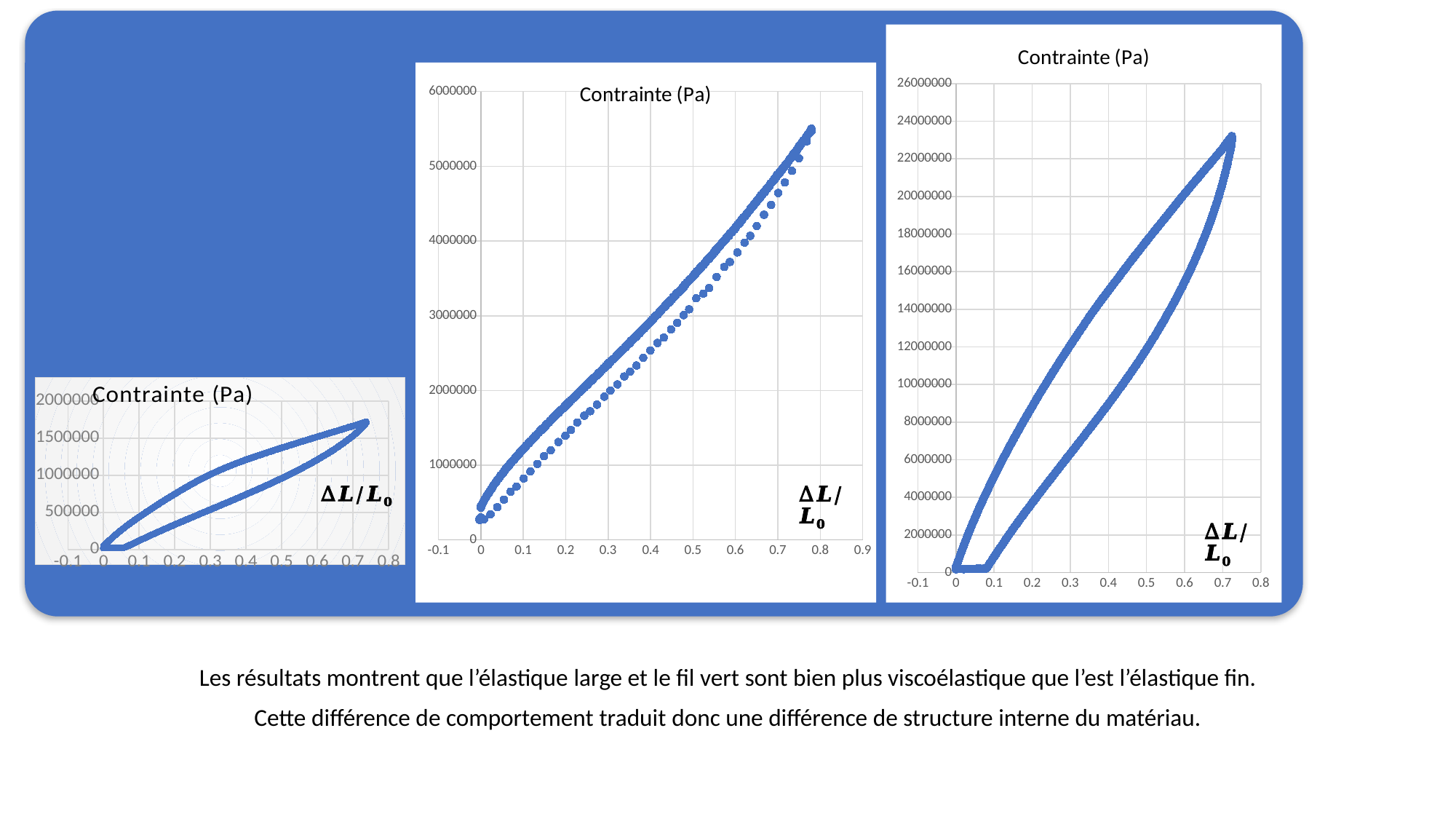
What is the title of the right-hand chart? Contrainte (Pa) In the middle chart, is the highest stress value reached greater or less than 6000000? less In the middle chart, does the stress rise or fall as ΔL/L0 increases? rises In the right-hand chart, is the highest stress value reached greater or less than 22000000? greater In the left-hand chart, is the highest stress value reached greater or less than 1500000? greater What quantity is plotted on the x axis of the middle chart? ΔL/L0 What kind of chart is the middle chart on the slide? scatter chart Which of the three charts reaches the highest stress (Contrainte) value? the right-hand chart How many charts are shown on the slide? 3